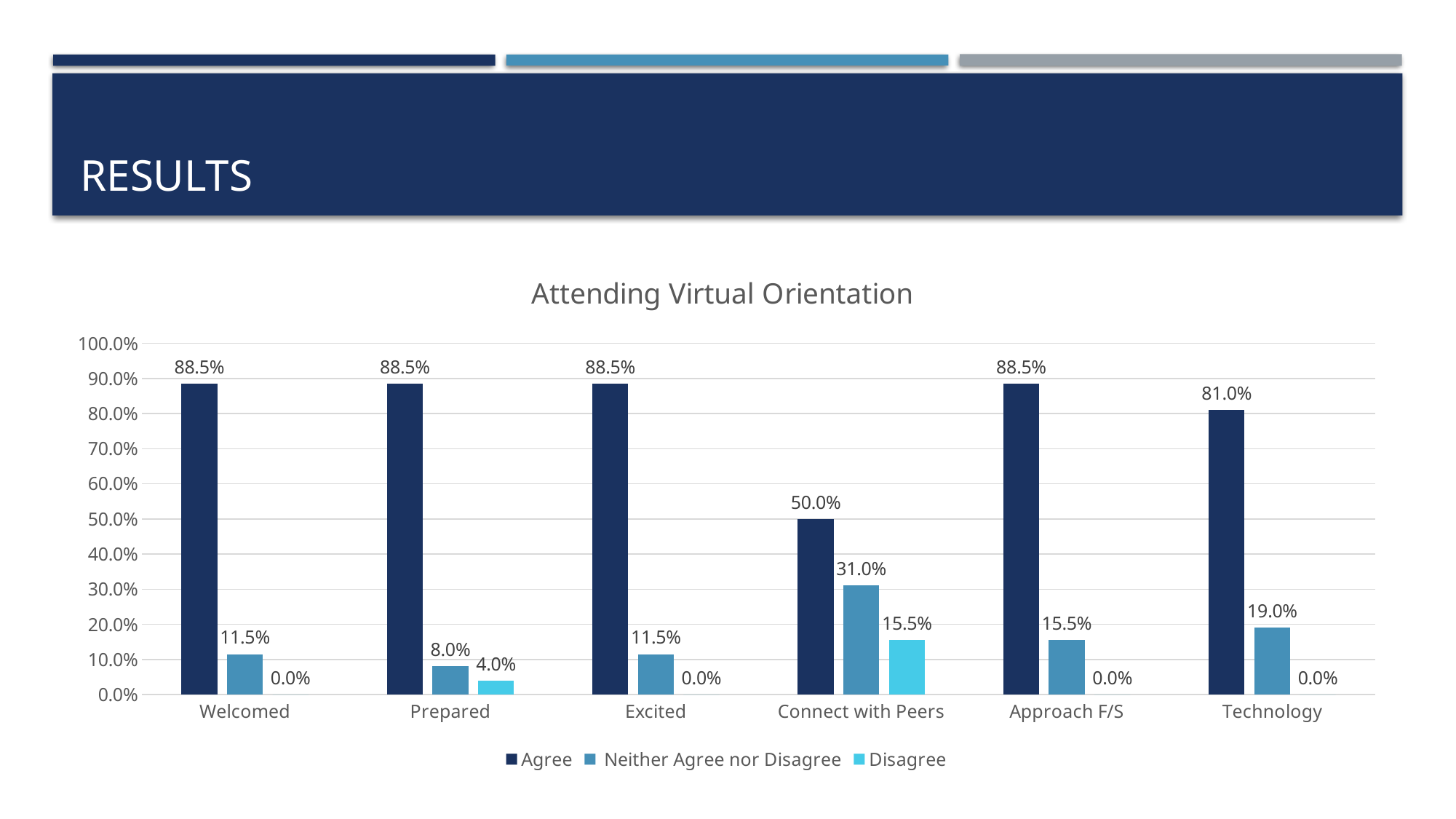
What is the title of the chart? Attending Virtual Orientation What is the difference between the Agree values for Welcomed and Technology? 7.5% What is the Neither Agree nor Disagree value for Technology? 19.0% What is the Agree value for Connect with Peers? 50.0% What is the Agree value for Technology? 81.0% Which category has the highest Disagree value? Connect with Peers How many series does the legend list? 3 Which category has the lowest Agree value? Connect with Peers Which is larger: the Neither Agree nor Disagree value for Approach F/S or for Technology? Technology How many categories are shown on the x axis? 6 What is the Disagree value for Prepared? 4.0% Which category has the highest Neither Agree nor Disagree value? Connect with Peers